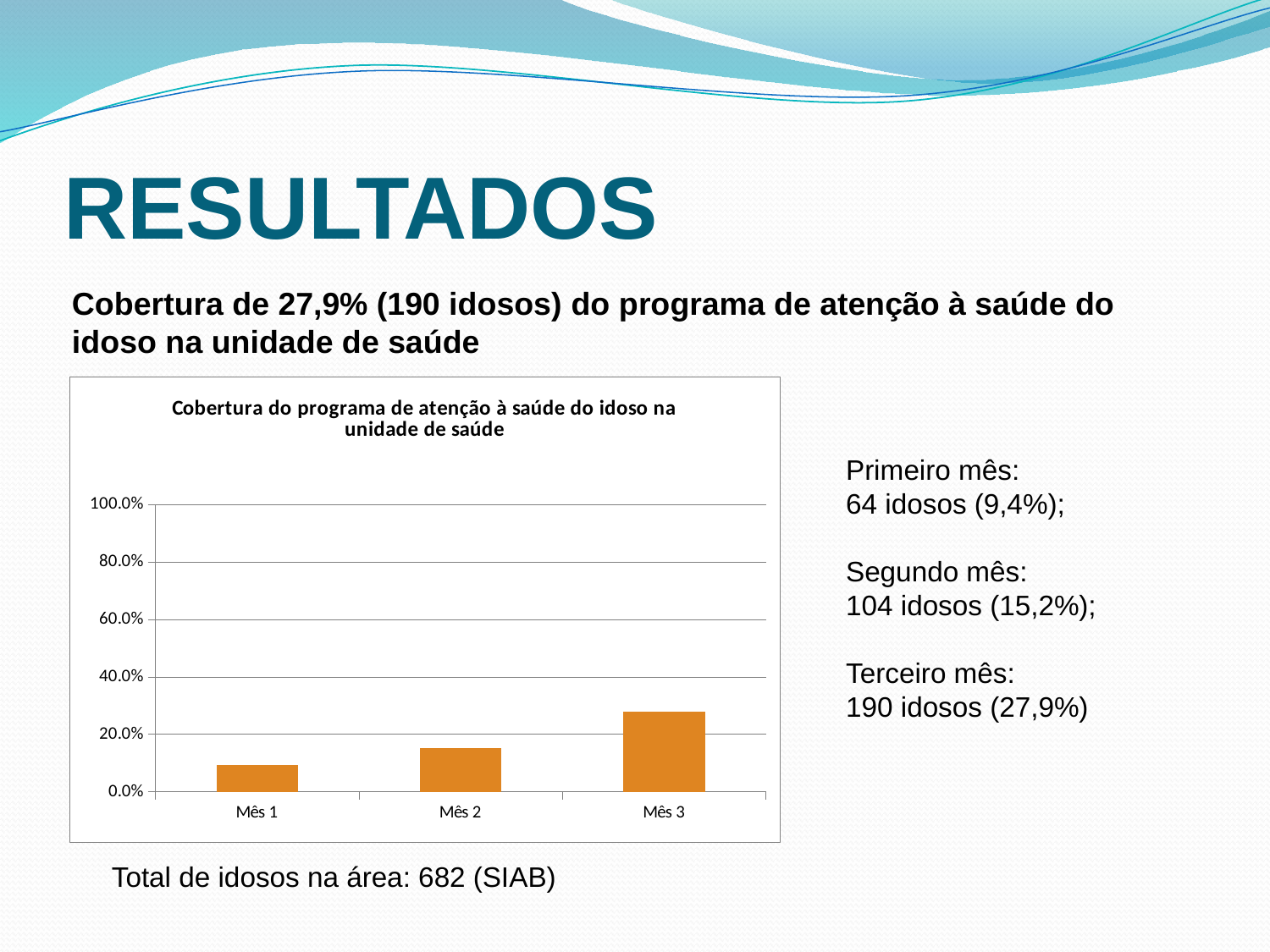
Is the value for Mês 3 greater or less than 40.0%? less Which is larger, the value for Mês 2 or the value for Mês 3? Mês 3 What kind of chart is shown on the slide? bar chart Is the value for Mês 1 greater or less than 20.0%? less Which month has the highest bar in the chart? Mês 3 Is the value for Mês 3 greater or less than 20.0%? greater How many categories are plotted on the x axis of the chart? 3 What is the title of the chart? Cobertura do programa de atenção à saúde do idoso na unidade de saúde Do the values rise or fall from Mês 1 to Mês 3? rise Which month has the lowest bar in the chart? Mês 1 What is the highest tick value shown on the y axis of the chart? 100.0%